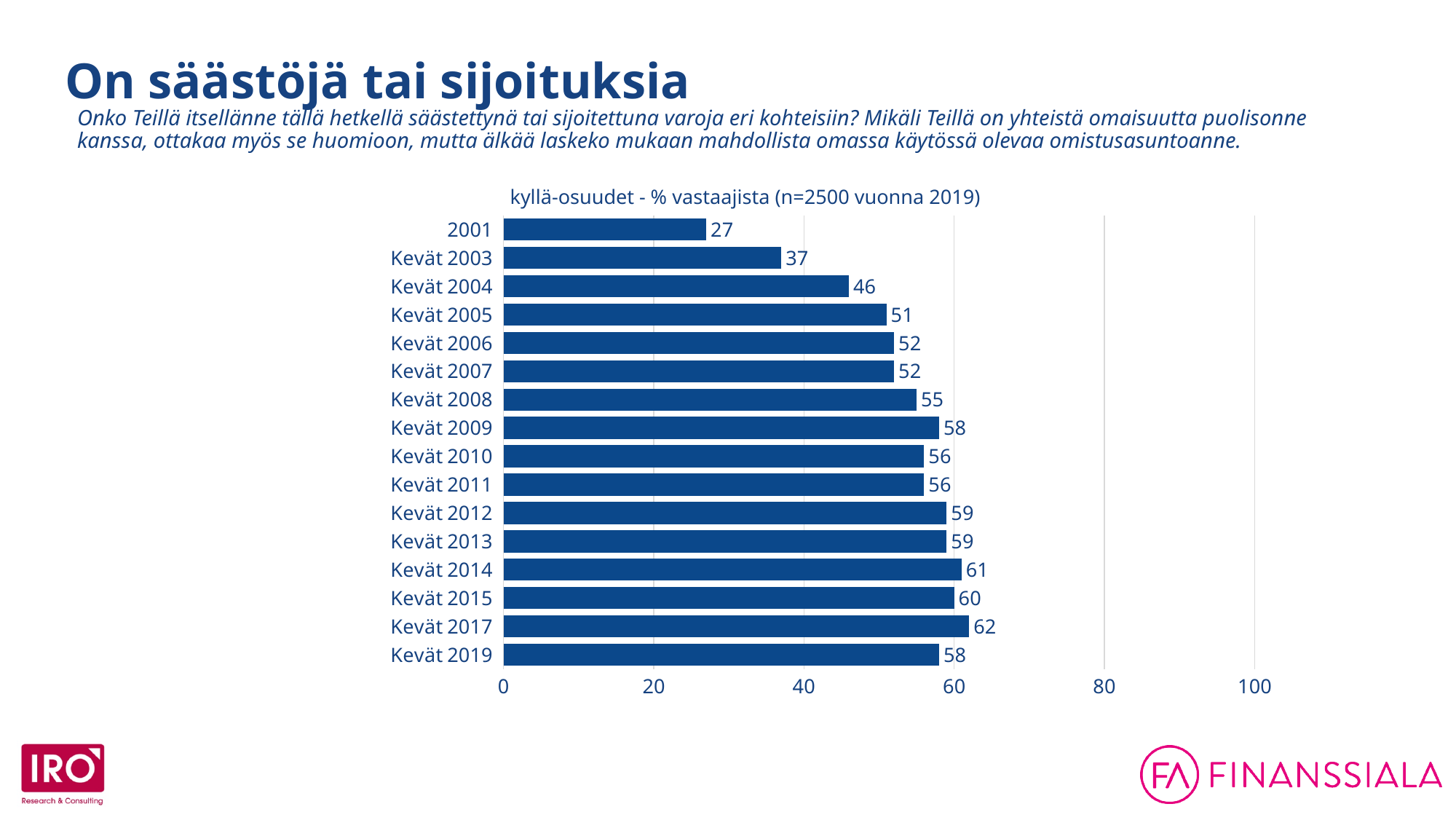
How many categories are shown on the chart? 16 What is the title of the chart? kyllä-osuudet - % vastaajista (n=2500 vuonna 2019) Which is larger, the value for Kevät 2004 or the value for Kevät 2008? Kevät 2008 Which category has the lowest value? 2001 What is the difference between the values for Kevät 2017 and 2001? 35 What is the value for 2001? 27 What is the value for Kevät 2014? 61 What is the value for Kevät 2019? 58 Which category has the highest value? Kevät 2017 Is the value for Kevät 2003 greater or less than 40? less Do the values generally rise or fall from 2001 to Kevät 2017? rise What kind of chart is shown on the slide? bar chart